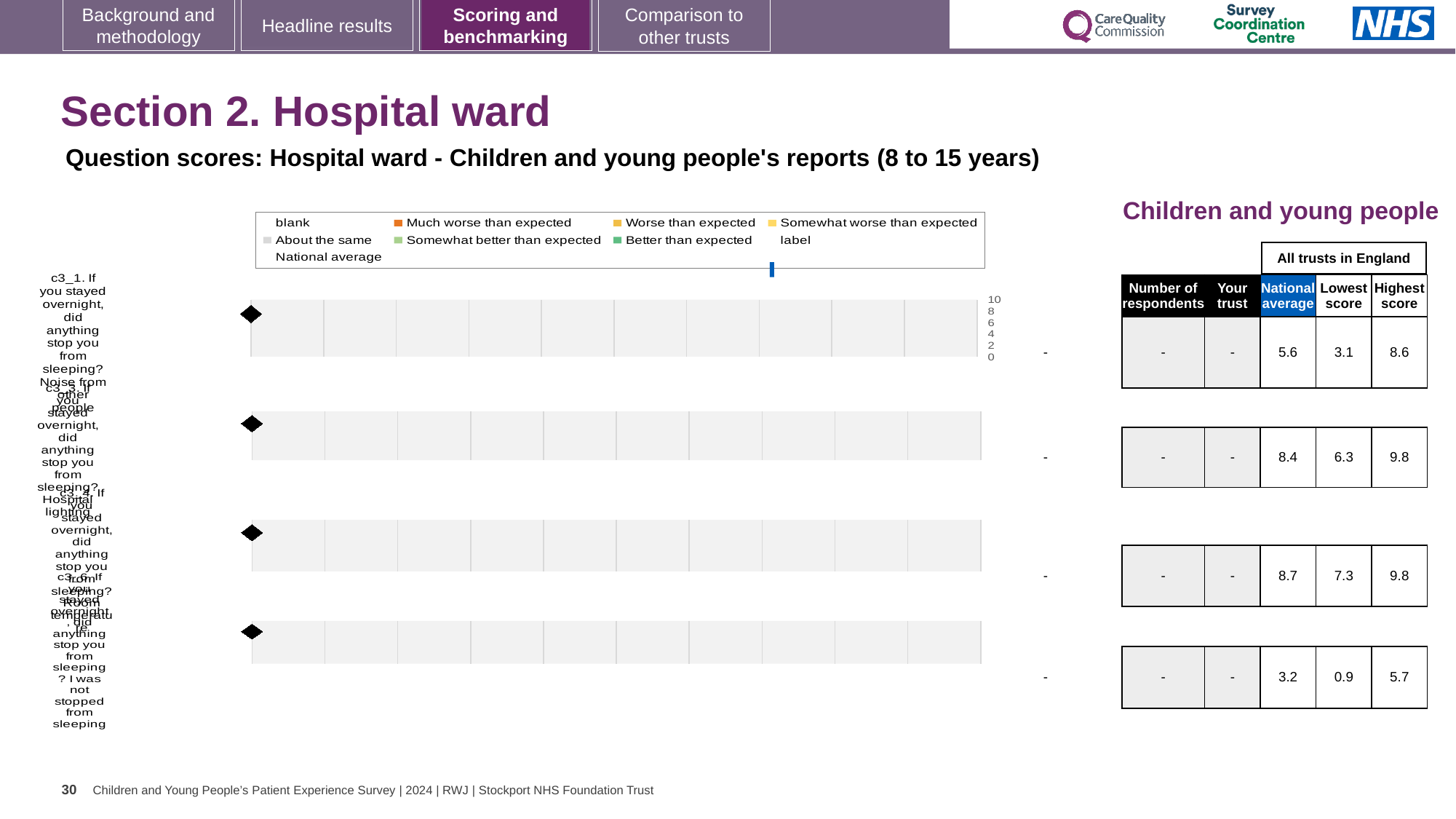
What is the highest value shown on the chart's score axis? 10 In the table, what is the Your trust value for the first question row? - What is the difference between the Highest score and the Lowest score for the first question row? 5.5 Is the National average larger for the second question row or the third question row? the third row How many question rows (charts) are shown on the slide? 4 Which question row has the lowest National average in the table? the fourth row (3.2) For the fourth question row, how much higher is the Highest score than the National average? 2.5 Which question row has the highest National average in the table? the third row (8.7) What kind of chart is used for the question scores on this slide? bar chart In the table, what is the National average for the first (top) question row? 5.6 In the table, what is the Lowest score for the fourth (bottom) question row? 0.9 In the table, what is the Highest score for the second question row? 9.8